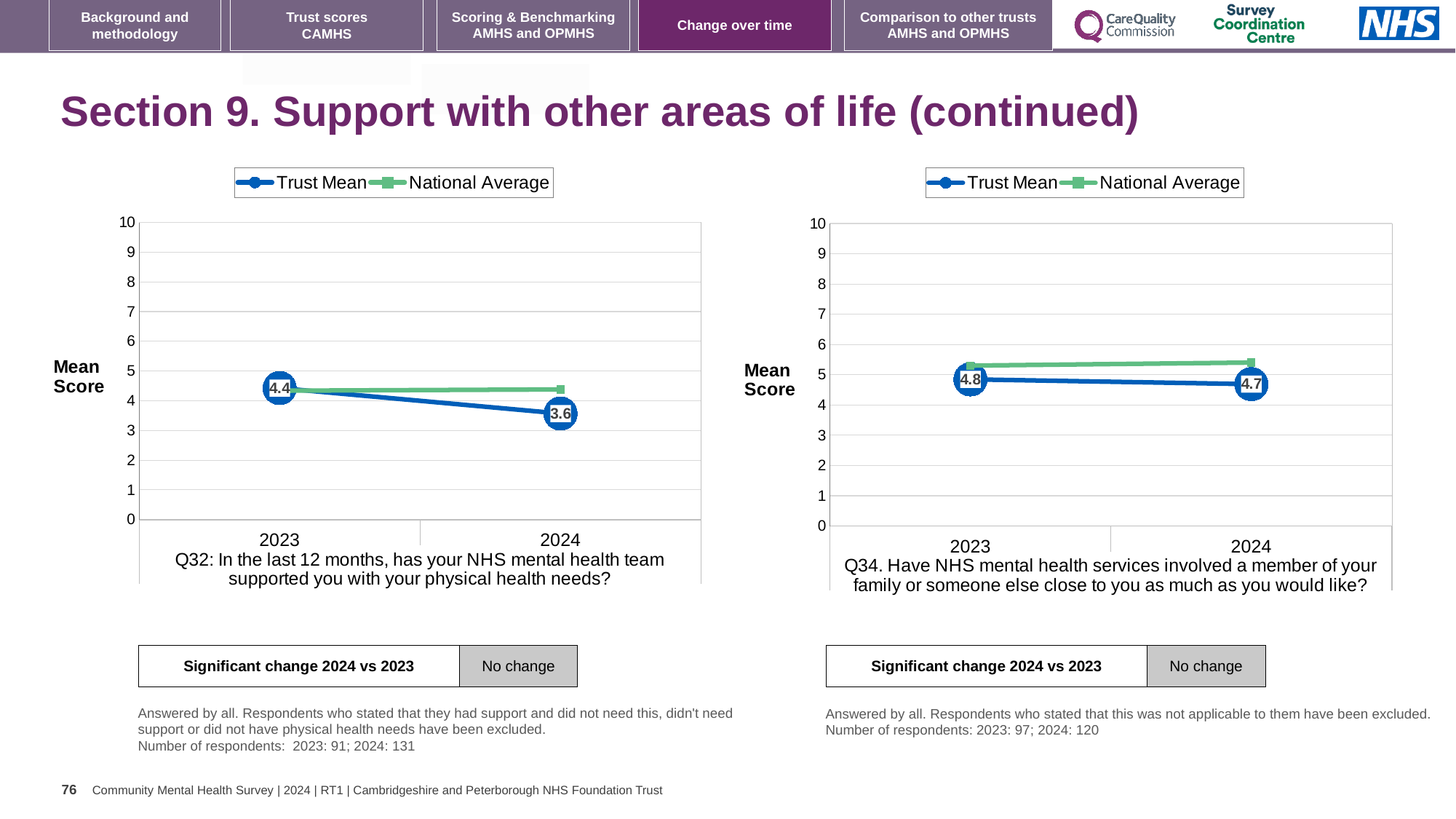
In the left chart (Q32), which year has the higher Trust Mean, 2023 or 2024? 2023 In the left chart (Q32), does the Trust Mean rise or fall from 2023 to 2024? fall In the right chart (Q34), is the National Average for 2024 greater or less than 5? greater In the right chart (Q34), what is the Trust Mean score for 2023? 4.8 What kind of chart is the right chart (Q34)? line chart In the left chart (Q32), is the National Average for 2024 greater or less than 5? less In the left chart (Q32), what is the Trust Mean score for 2023? 4.4 In the right chart (Q34), what is the Trust Mean score for 2024? 4.7 In the left chart (Q32), by how much did the Trust Mean fall from 2023 to 2024? 0.8 How many series does the legend of the left chart (Q32) list? 2 In the left chart (Q32), what is the Trust Mean score for 2024? 3.6 In the right chart (Q34), which series is higher in 2024, Trust Mean or National Average? National Average